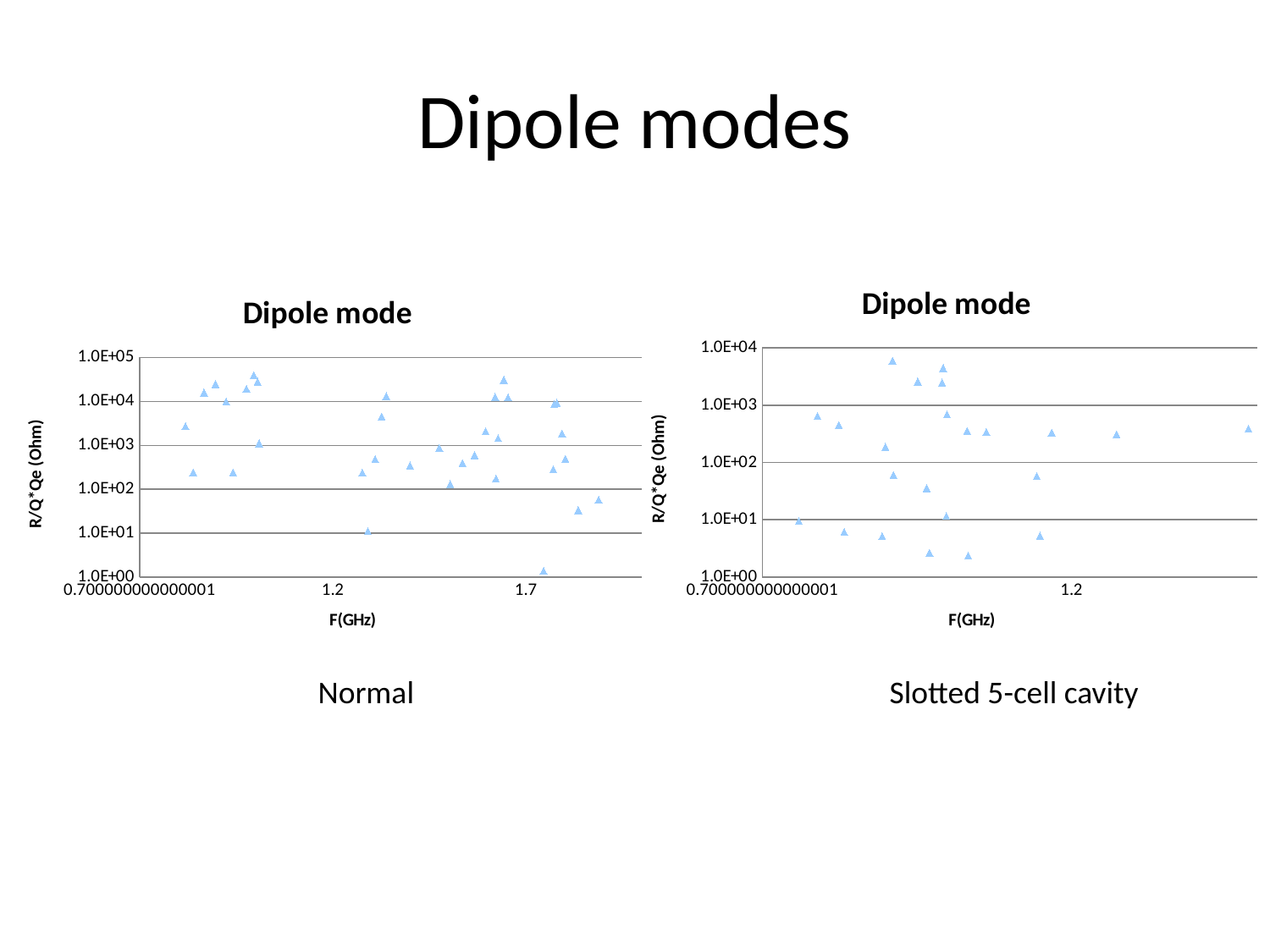
In the left chart labelled Normal, is the lowest plotted value greater or less than 1.0E+01? less In the left chart labelled Normal, is the highest plotted value greater or less than 1.0E+04? greater Which chart has the higher maximum plotted value, the left chart labelled Normal or the right chart labelled Slotted 5-cell cavity? Normal What kind of chart is the left chart labelled Normal? scatter chart What is the title of the left chart labelled Normal? Dipole mode What is the y-axis label of the right chart labelled Slotted 5-cell cavity? R/Q*Qe (Ohm) What kind of chart is the right chart labelled Slotted 5-cell cavity? scatter chart In the right chart labelled Slotted 5-cell cavity, is the lowest plotted value greater or less than 1.0E+01? less